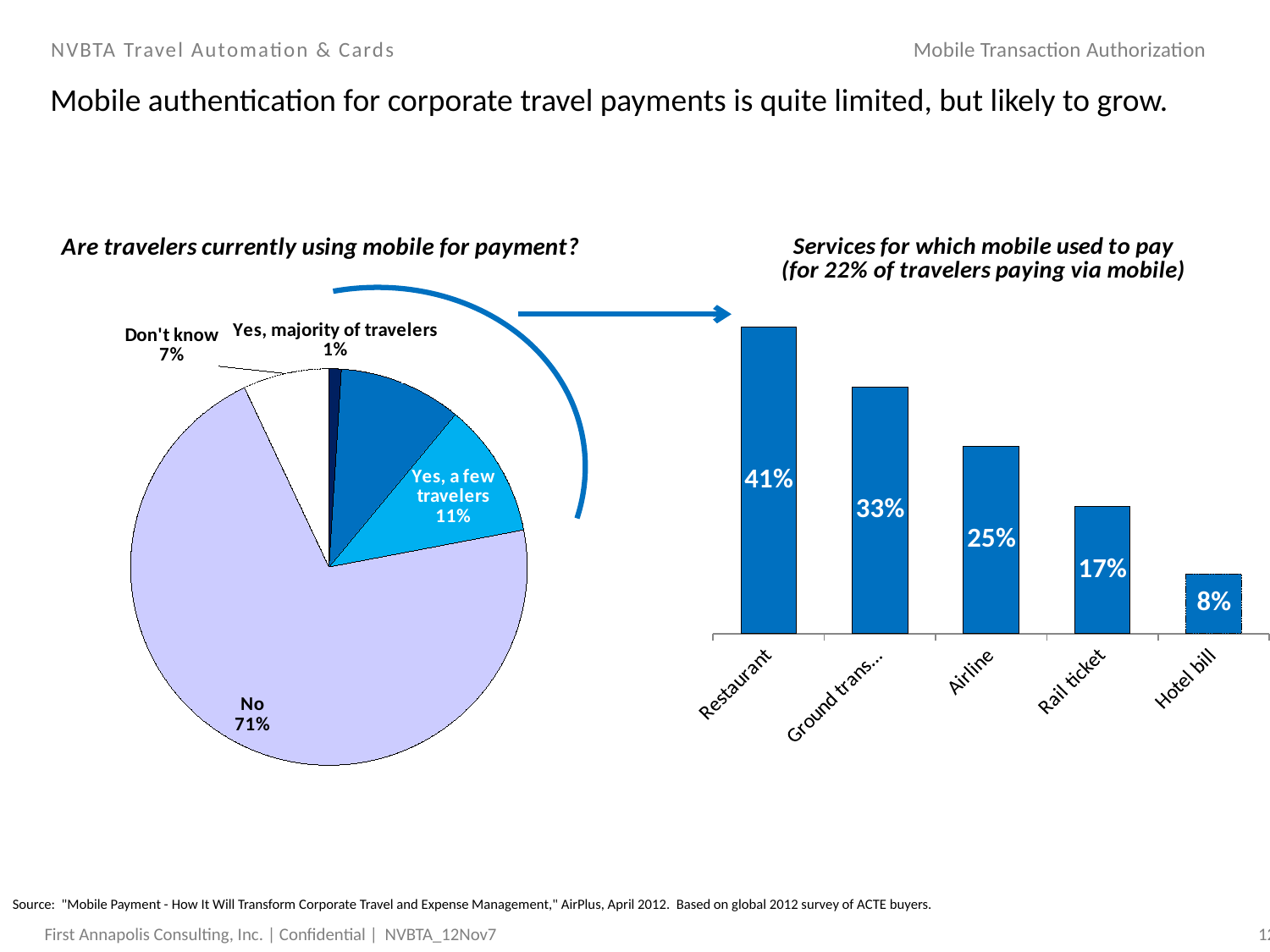
In the bar chart 'Services for which mobile used to pay', what is the difference between the values for Restaurant and Airline? 16% In the pie chart 'Are travelers currently using mobile for payment?', what is the value for 'Don't know'? 7% How many bars are in the bar chart 'Services for which mobile used to pay'? 5 In the bar chart 'Services for which mobile used to pay', what is the value for Hotel bill? 8% In the bar chart 'Services for which mobile used to pay', what is the value for Restaurant? 41% In the bar chart 'Services for which mobile used to pay', which is larger, the value for Airline or the value for Rail ticket? Airline In the bar chart 'Services for which mobile used to pay', do the values rise or fall from left to right? Fall What kind of chart is the chart on the right of the slide? Bar chart In the pie chart 'Are travelers currently using mobile for payment?', what share is 'No'? 71% In the bar chart 'Services for which mobile used to pay', which service has the lowest value? Hotel bill In the pie chart 'Are travelers currently using mobile for payment?', what is the difference between the 'No' share and the 'Yes, a few travelers' share? 60% In the bar chart 'Services for which mobile used to pay', which service has the highest value? Restaurant